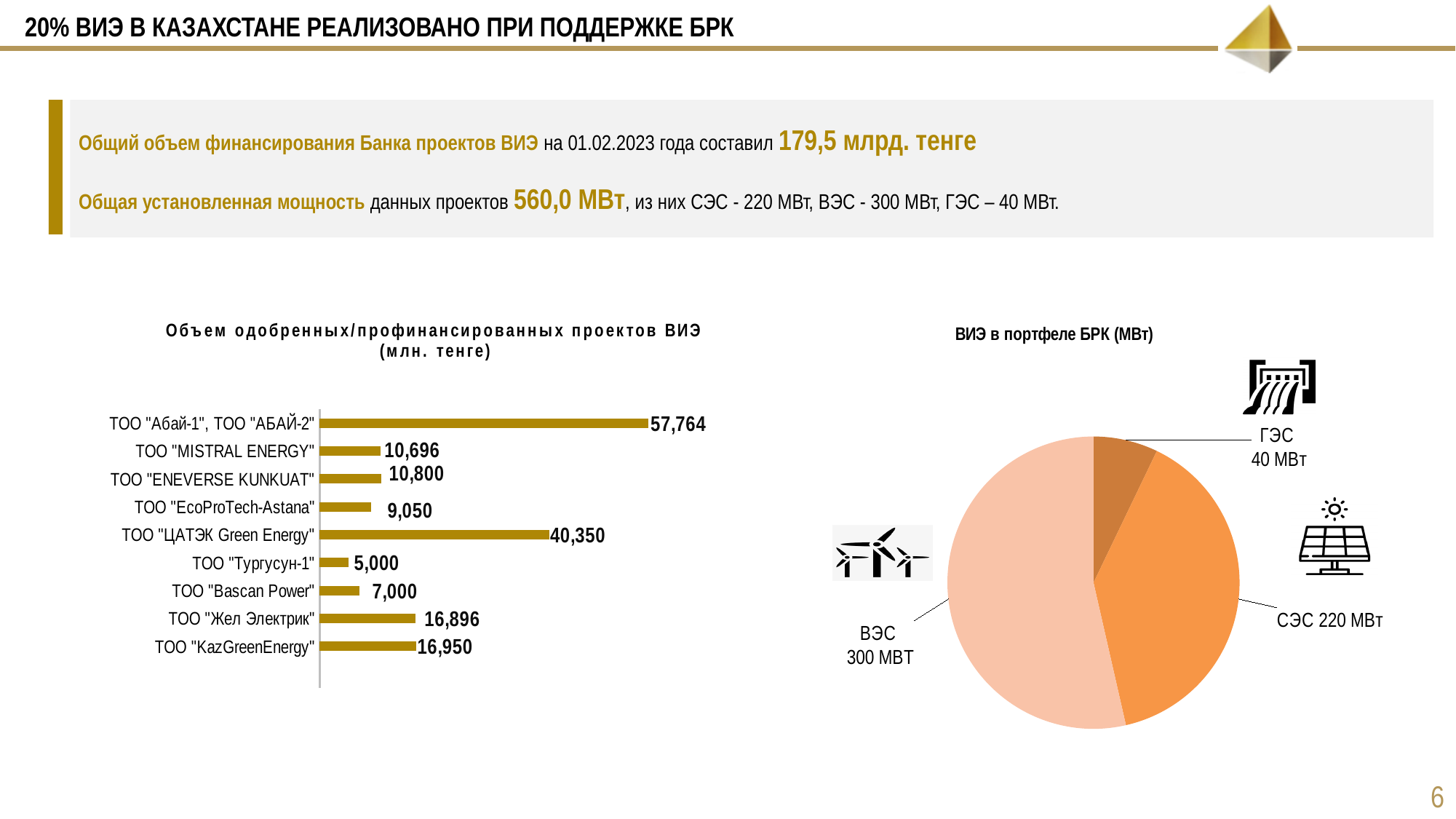
How many companies are shown in the bar chart "Объем одобренных/профинансированных проектов ВИЭ (млн. тенге)"? 9 In the bar chart "Объем одобренных/профинансированных проектов ВИЭ (млн. тенге)", which company has the highest value? ТОО "Абай-1", ТОО "АБАЙ-2" In the bar chart "Объем одобренных/профинансированных проектов ВИЭ (млн. тенге)", what is the value for ТОО "Абай-1", ТОО "АБАЙ-2"? 57,764 In the pie chart "ВИЭ в портфеле БРК (МВт)", what is the difference between СЭС and ГЭС? 180 МВт What kind of chart is "Объем одобренных/профинансированных проектов ВИЭ (млн. тенге)"? Bar chart How many slices does the pie chart "ВИЭ в портфеле БРК (МВт)" have? 3 In the bar chart "Объем одобренных/профинансированных проектов ВИЭ (млн. тенге)", which company has the lowest value? ТОО "Тургусун-1" In the bar chart "Объем одобренных/профинансированных проектов ВИЭ (млн. тенге)", what is the difference between ТОО "KazGreenEnergy" and ТОО "Жел Электрик"? 54 In the bar chart "Объем одобренных/профинансированных проектов ВИЭ (млн. тенге)", which is larger: ТОО "ENEVERSE KUNKUAT" or ТОО "MISTRAL ENERGY"? ТОО "ENEVERSE KUNKUAT" In the pie chart "ВИЭ в портфеле БРК (МВт)", which slice is the smallest? ГЭС In the bar chart "Объем одобренных/профинансированных проектов ВИЭ (млн. тенге)", what is the value for ТОО "ЦАТЭК Green Energy"? 40,350 In the pie chart "ВИЭ в портфеле БРК (МВт)", what is the value for ВЭС? 300 МВт